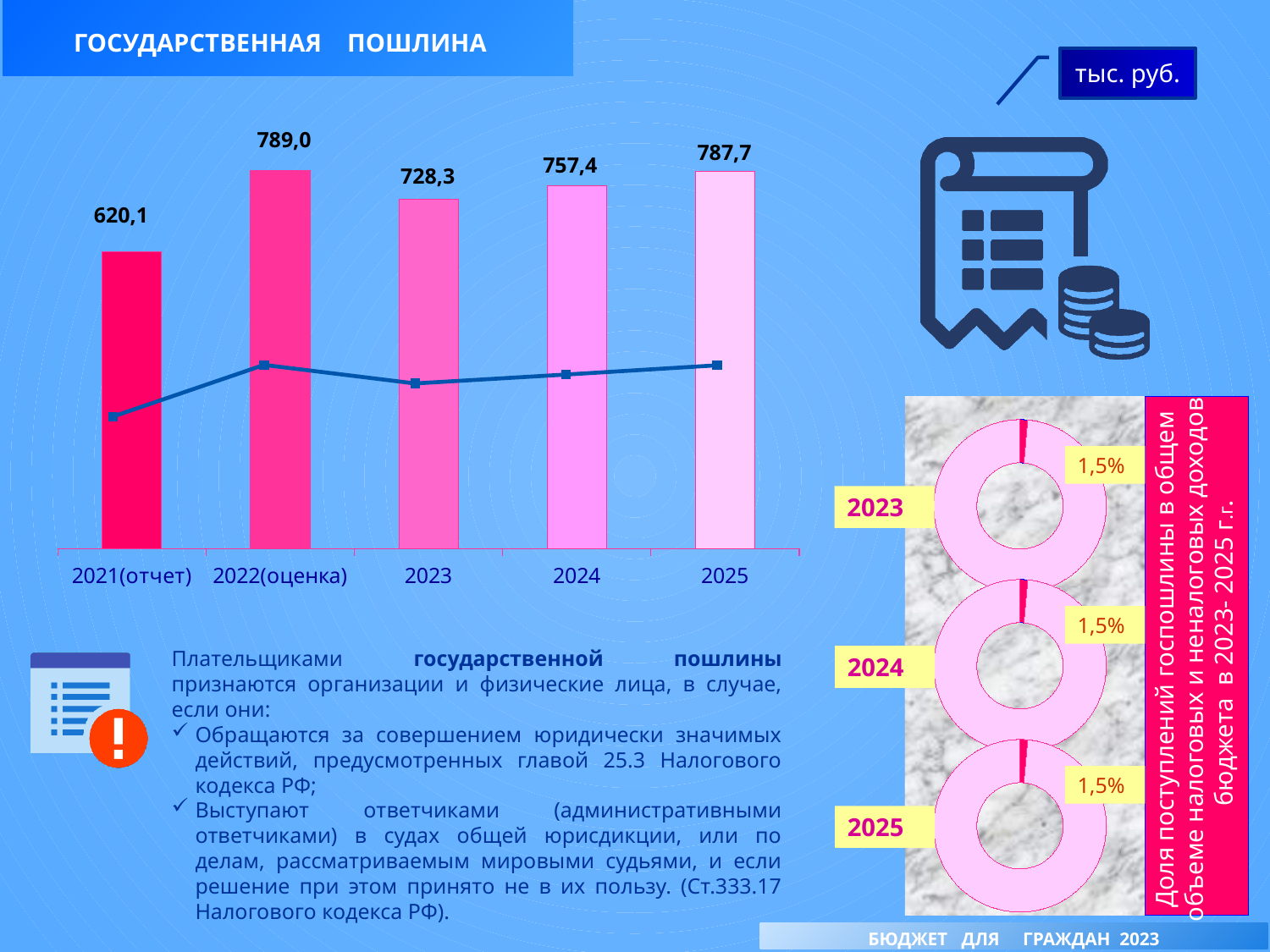
How many categories are shown on the x axis of the bar chart? 5 In the donut chart for 2023 on the right, what share is labelled? 1,5% In the bar chart, what is the value for 2024? 757,4 In the bar chart, which category has the highest value? 2022(оценка) In the bar chart, what is the difference between the values for 2025 and 2024? 30,3 In the bar chart, what is the value for 2022(оценка)? 789,0 In the bar chart, do the values rise or fall from 2023 to 2025? Rise In the bar chart, what is the value for 2021(отчет)? 620,1 What kind of chart is the large chart on the left of the slide? Bar chart with a line overlay In the bar chart, what is the difference between the values for 2022(оценка) and 2021(отчет)? 168,9 In the bar chart, which category has the lowest value? 2021(отчет) In the bar chart, which is larger: the value for 2023 or the value for 2024? 2024